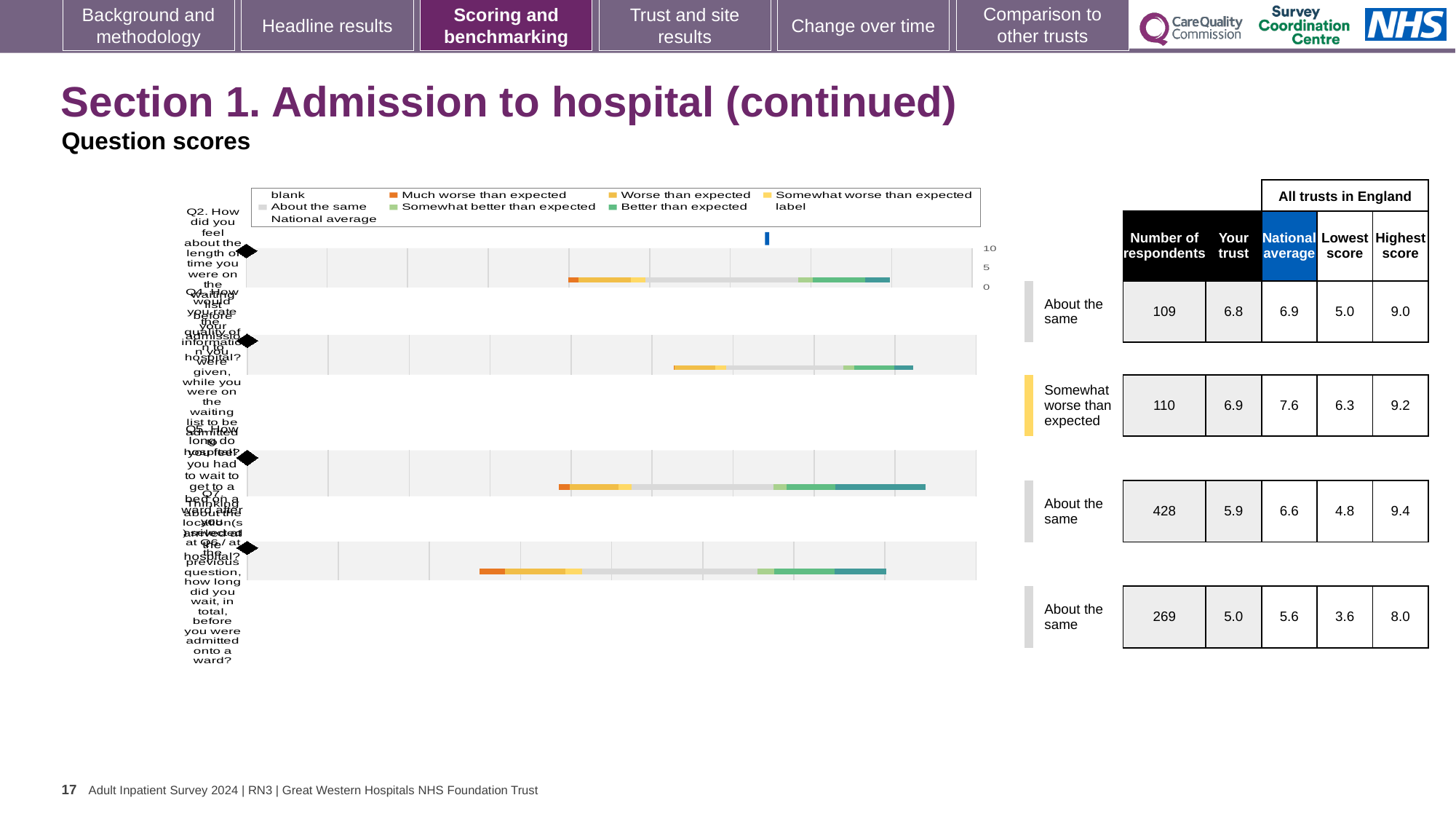
In the table next to the chart, what is the national average for the third question row? 6.6 Which benchmark category is the second question row assigned to? Somewhat worse than expected In the table next to the chart, what is the highest score for the fourth (bottom) question row? 8.0 For the second question row, what is the difference between the national average and the 'Your trust' score? 0.7 In the table next to the chart, what is the number of respondents for the first (top) question row? 109 For the first question row, is the 'Your trust' score larger or smaller than the national average? smaller How many question rows are plotted in the chart? 4 Which question row has the highest number of respondents in the table? the third row (428) Which benchmark category is the fourth (bottom) question row assigned to? About the same Which question row has the lowest 'Your trust' score in the table? the fourth row (5.0) What kind of chart is shown on the slide? bar chart In the table next to the chart, what is the 'Your trust' score for the second question row? 6.9